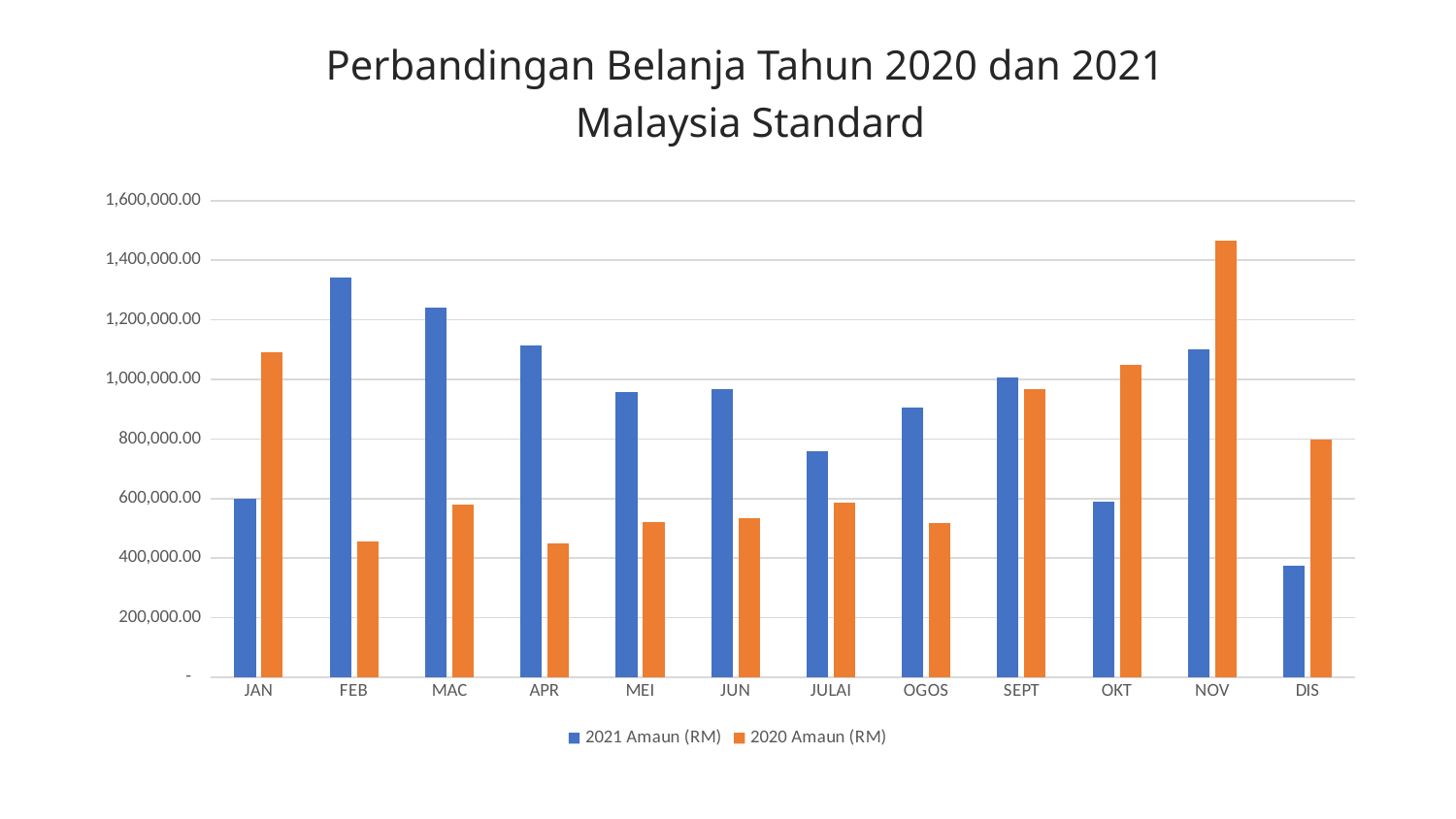
In NOV, which series has the larger value, 2021 Amaun (RM) or 2020 Amaun (RM)? 2020 Amaun (RM) How many series does the legend list? 2 How many months are shown on the x axis? 12 Which month has the highest value for 2021 Amaun (RM)? FEB What kind of chart is shown on the slide? bar chart In FEB, which series has the larger value, 2021 Amaun (RM) or 2020 Amaun (RM)? 2021 Amaun (RM) Is the value for 2020 Amaun (RM) in OKT greater or less than 1,000,000.00? greater Is the value for 2021 Amaun (RM) in FEB greater or less than 1,200,000.00? greater Does the value for 2021 Amaun (RM) rise or fall from FEB to MEI? fall Which month has the lowest value for 2021 Amaun (RM)? DIS Which month has the highest value for 2020 Amaun (RM)? NOV Is the value for 2021 Amaun (RM) in DIS greater or less than 400,000.00? less